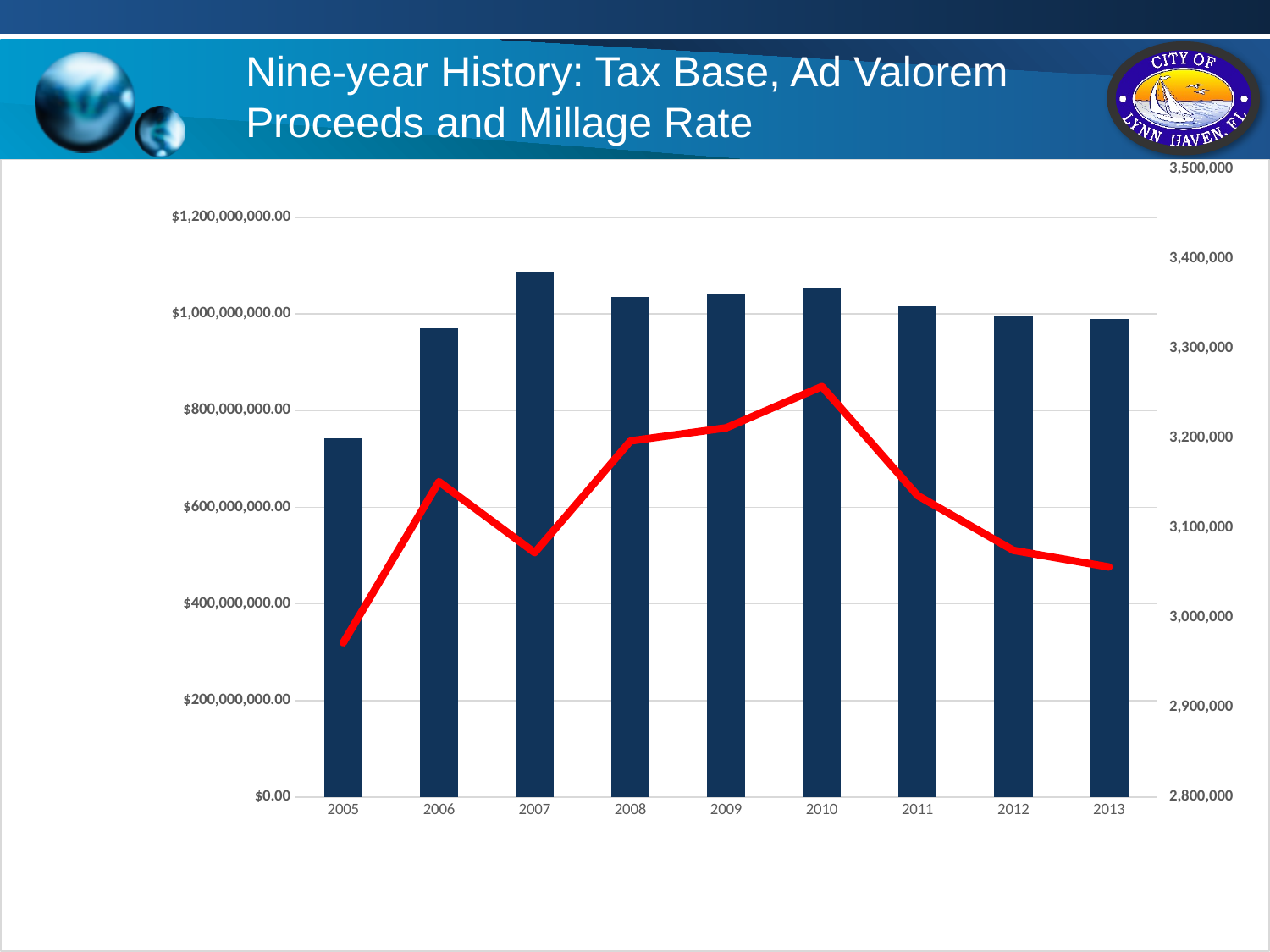
Which year has the tallest bar in the chart? 2007 Do the bars rise or fall from 2010 to 2013? fall How many years are shown on the x axis of the chart? 9 Is the bar value for 2006 greater or less than $1,000,000,000.00? less Which bar is taller, 2007 or 2013? 2007 Is the red line value for 2005 greater or less than 3,000,000 on the right axis? less Which bar is taller, 2005 or 2006? 2006 In which year is the red line at its lowest point? 2005 In which year does the red line reach its highest point? 2010 Is the bar value for 2007 greater or less than $1,000,000,000.00? greater Which year has the shortest bar in the chart? 2005